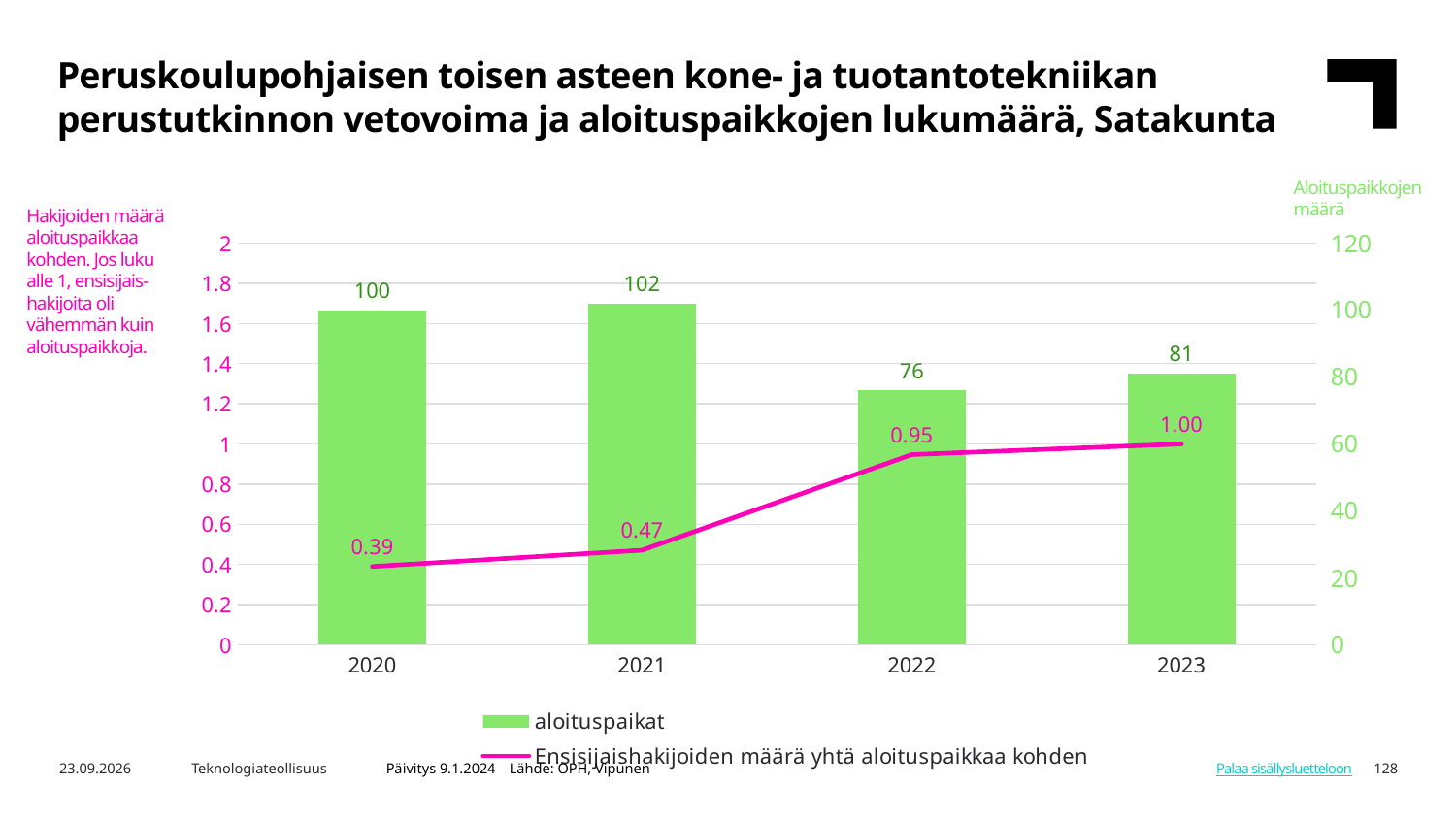
Is the value of aloituspaikat for 2022 greater or less than 80? less Which year has the lowest value of Ensisijaishakijoiden määrä yhtä aloituspaikkaa kohden? 2020 Does the Ensisijaishakijoiden määrä yhtä aloituspaikkaa kohden line rise or fall from 2020 to 2023? rise What is the value of aloituspaikat for 2020? 100 What is the difference in aloituspaikat between 2021 and 2022? 26 Which year has the highest value of aloituspaikat? 2021 What is the value of aloituspaikat for 2023? 81 How many years are shown on the x axis? 4 Which year has a larger value of aloituspaikat, 2022 or 2023? 2023 What is the value of Ensisijaishakijoiden määrä yhtä aloituspaikkaa kohden for 2022? 0.95 What colour are the aloituspaikat bars? green How many series does the legend list? 2